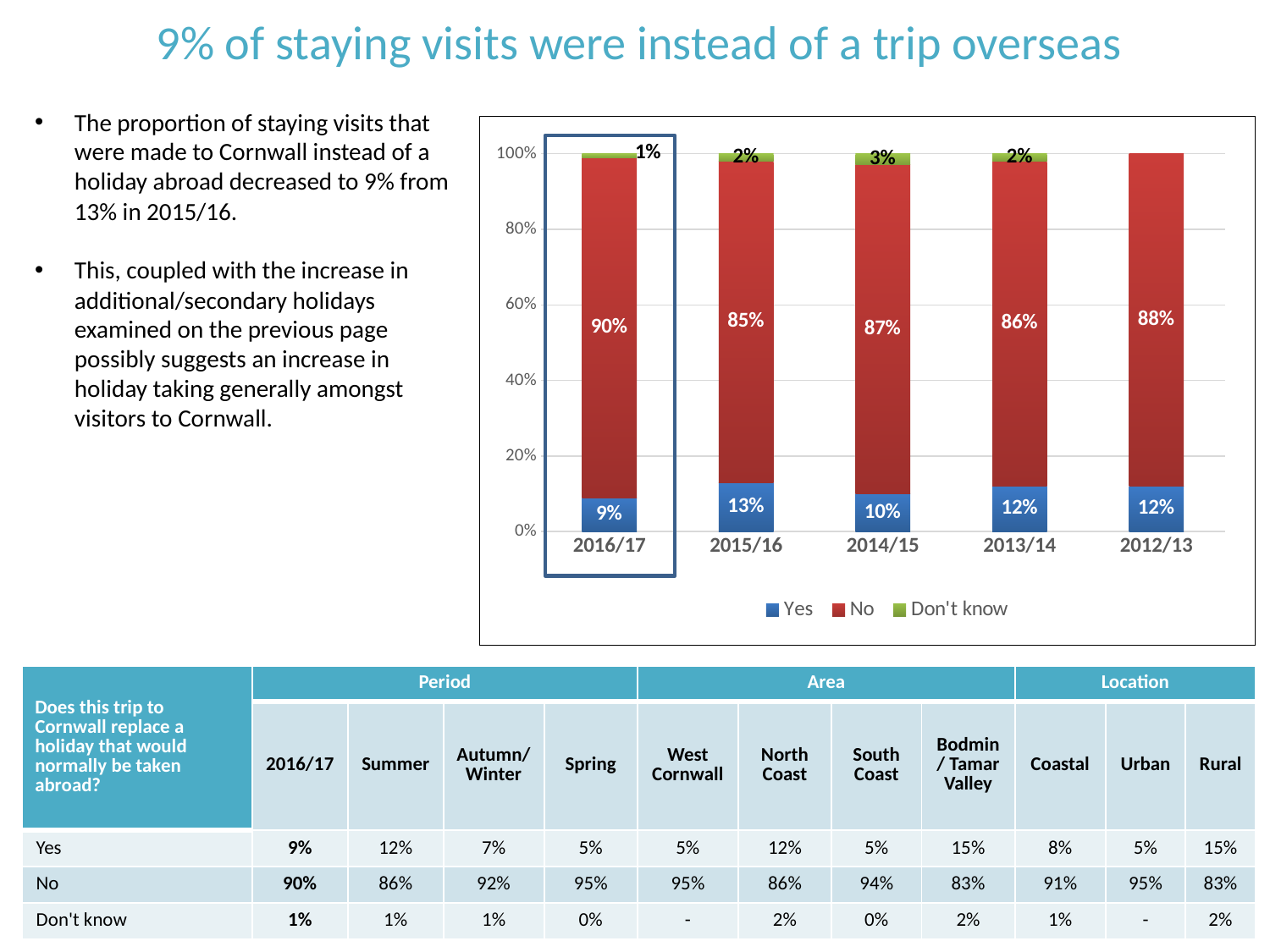
What is the 'Yes' value for 2016/17? 9% How many years are shown on the x axis? 5 Which year has the lowest 'Yes' value? 2016/17 Which year has the highest 'Yes' value? 2015/16 What kind of chart is shown? Stacked bar chart Is the 'No' value larger for 2014/15 or 2015/16? 2014/15 What is the 'Don't know' value for 2014/15? 3% What is the difference between the 'Yes' values for 2015/16 and 2016/17? 4% What is the 'No' value for 2012/13? 88% How many series does the legend list? 3 Which series is shown in red? No Which year has the highest 'No' value? 2016/17